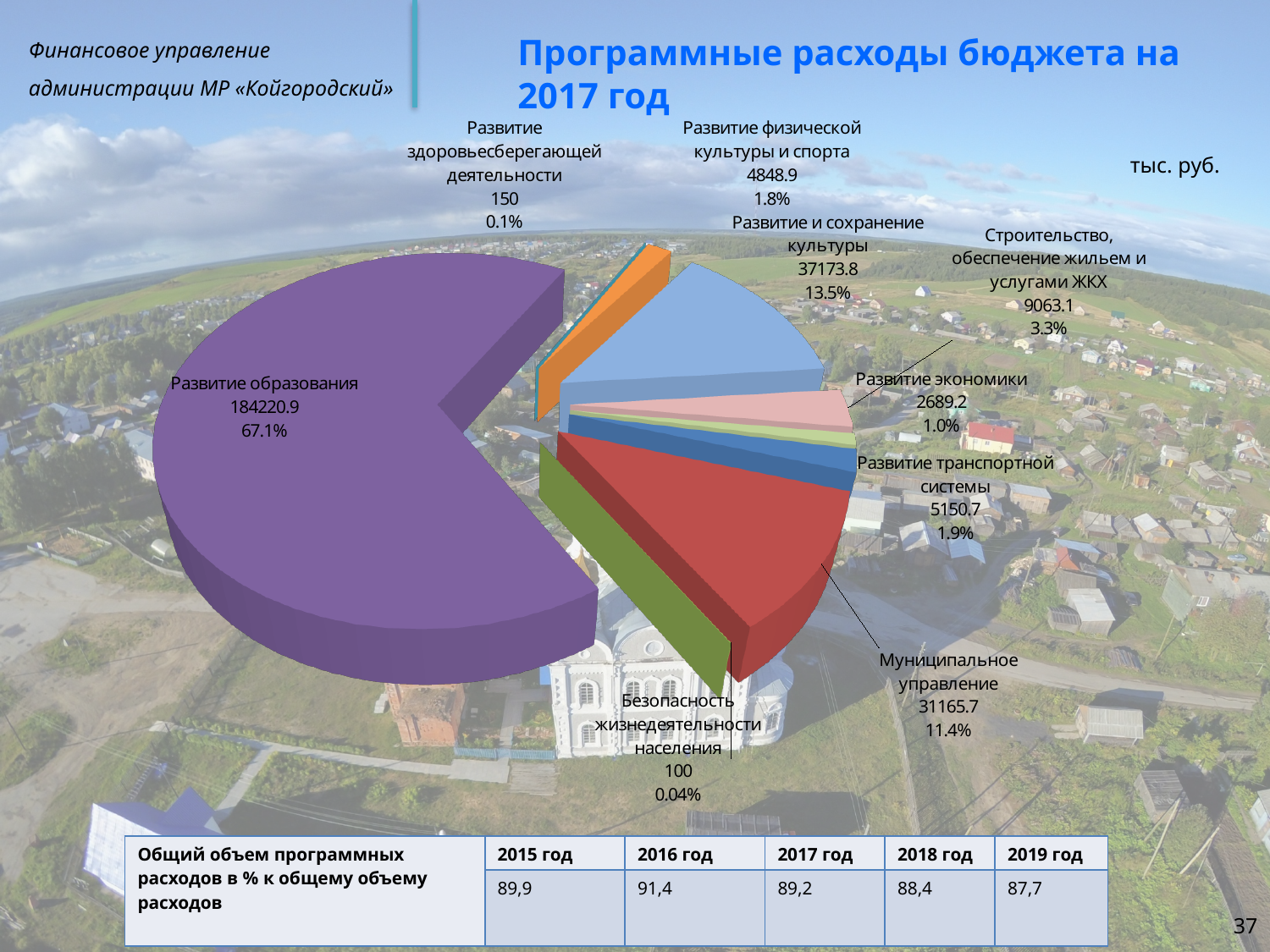
Which category has the largest share of the pie? Развитие образования Which category has the smallest share of the pie? Безопасность жизнедеятельности населения How many categories (slices) does the pie chart have? 9 What is the title of the chart? Программные расходы бюджета на 2017 год What type of chart is shown on the slide? Pie chart What is the value for Развитие образования? 184220.9 What is the value for Развитие и сохранение культуры? 37173.8 What is the difference between the values for Развитие и сохранение культуры and Муниципальное управление? 6008.1 What is the value for Строительство, обеспечение жильем и услугами ЖКХ? 9063.1 Which is larger: Развитие транспортной системы or Развитие физической культуры и спорта? Развитие транспортной системы What share of the pie does Развитие и сохранение культуры represent? 13.5% What is the value for Муниципальное управление? 31165.7